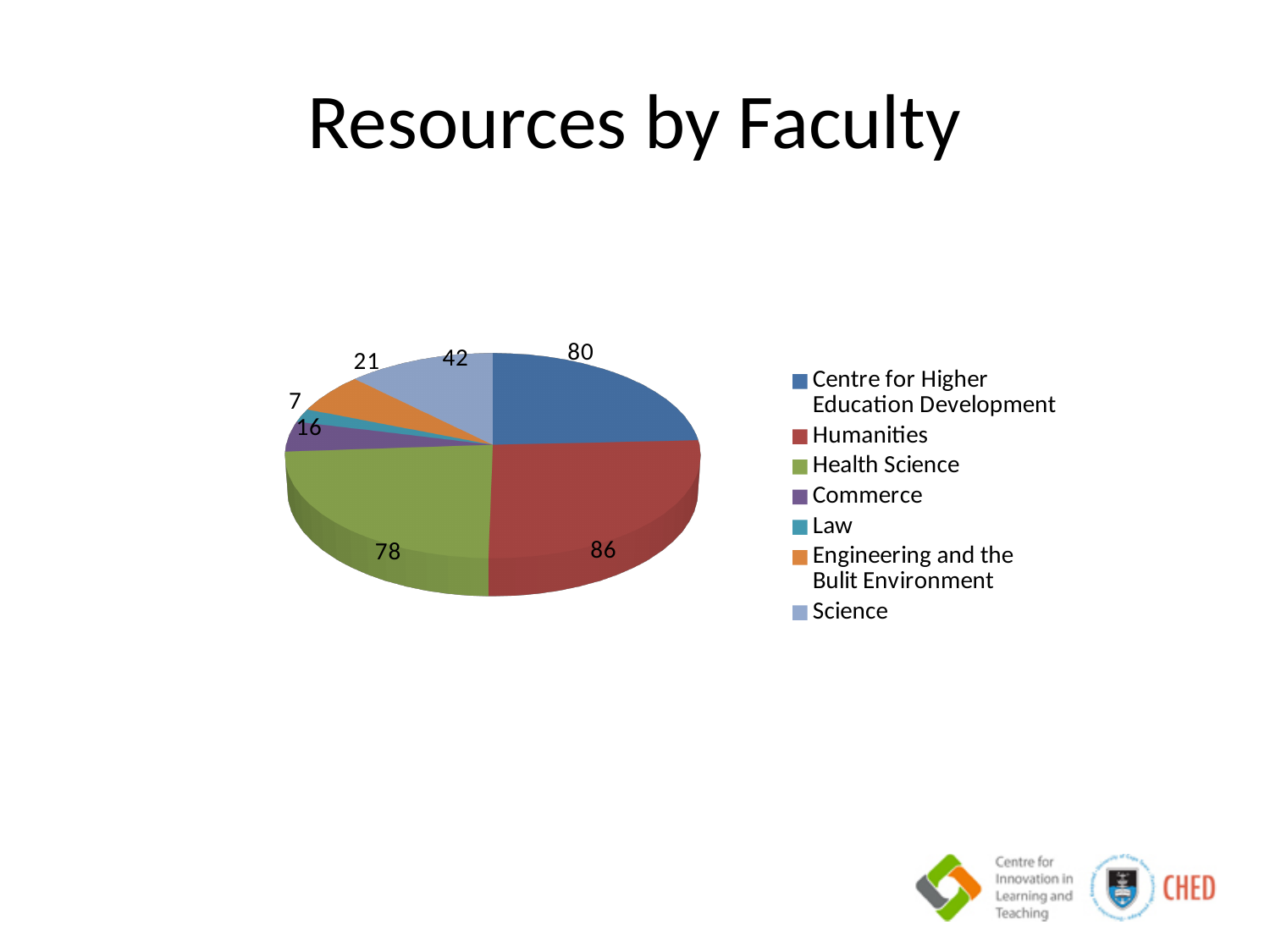
What is the difference between the values for Humanities and Health Science? 8 Which faculty has the highest value? Humanities What is the value for Humanities? 86 What is the title of the slide containing the chart? Resources by Faculty How many categories does the pie chart have? 7 What is the difference between the values for Science and Engineering and the Bulit Environment? 21 Which is larger, the value for Commerce or the value for Engineering and the Bulit Environment? Engineering and the Bulit Environment What is the value for Science? 42 What is the value for Centre for Higher Education Development? 80 What type of chart is shown on the slide? Pie chart Which faculty has the lowest value? Law What is the value for Law? 7